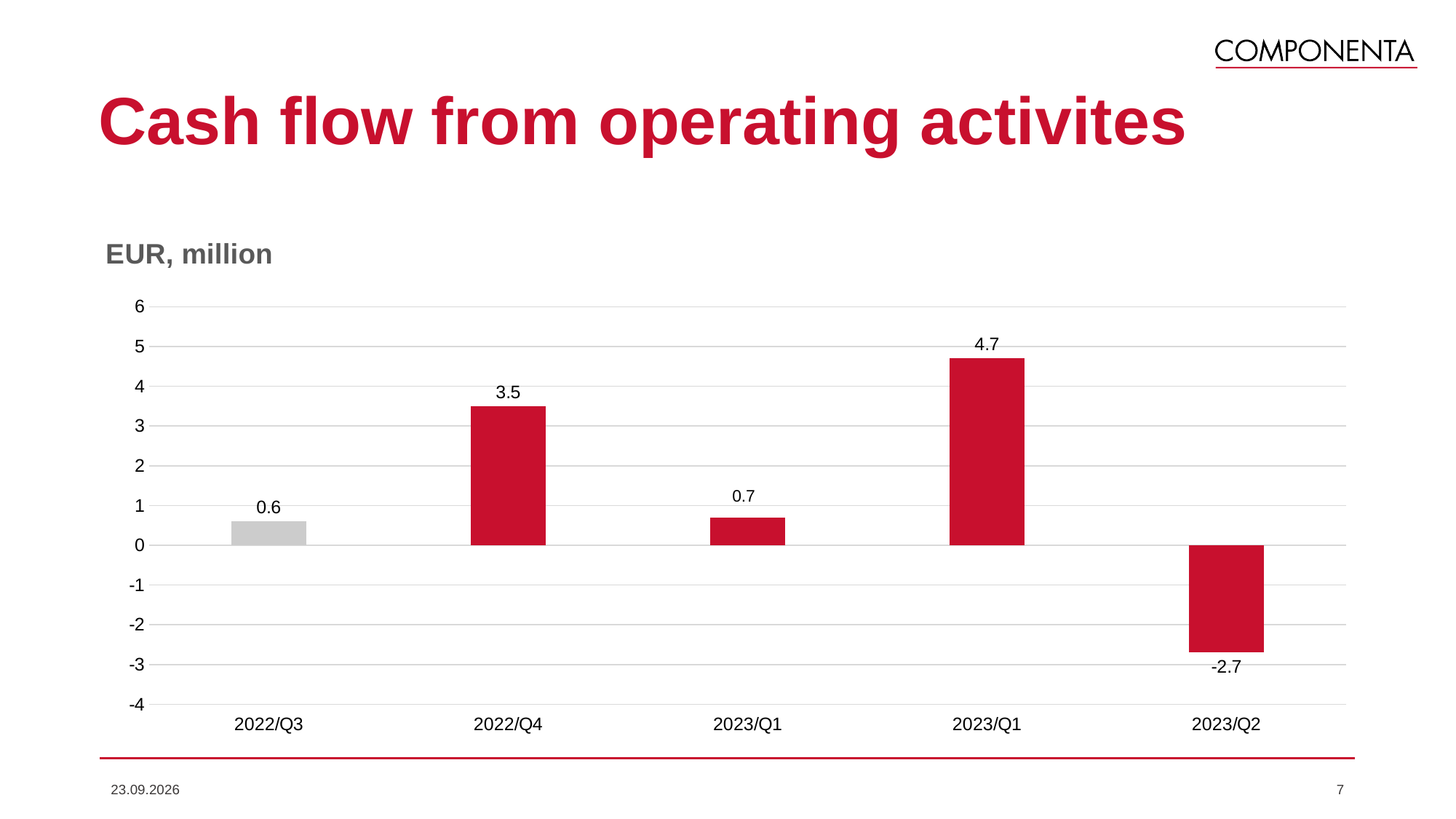
Is the value for 2023/Q2 greater or less than 0? less Which quarter has the lowest cash flow from operating activities? 2023/Q2 What is the value shown for 2022/Q3? 0.6 Which is larger, the value for 2022/Q4 or the value for 2022/Q3? 2022/Q4 What is the cash flow from operating activities for 2022/Q4? 3.5 What kind of chart is shown on the slide? Bar chart What colour is the bar for 2022/Q3? Grey What is the highest value shown on the chart? 4.7 What is the difference between the values for 2022/Q4 and 2022/Q3? 2.9 What unit is the chart measured in, according to the label above it? EUR, million How many bars are shown on the chart? 5 What is the value shown for 2023/Q2? -2.7